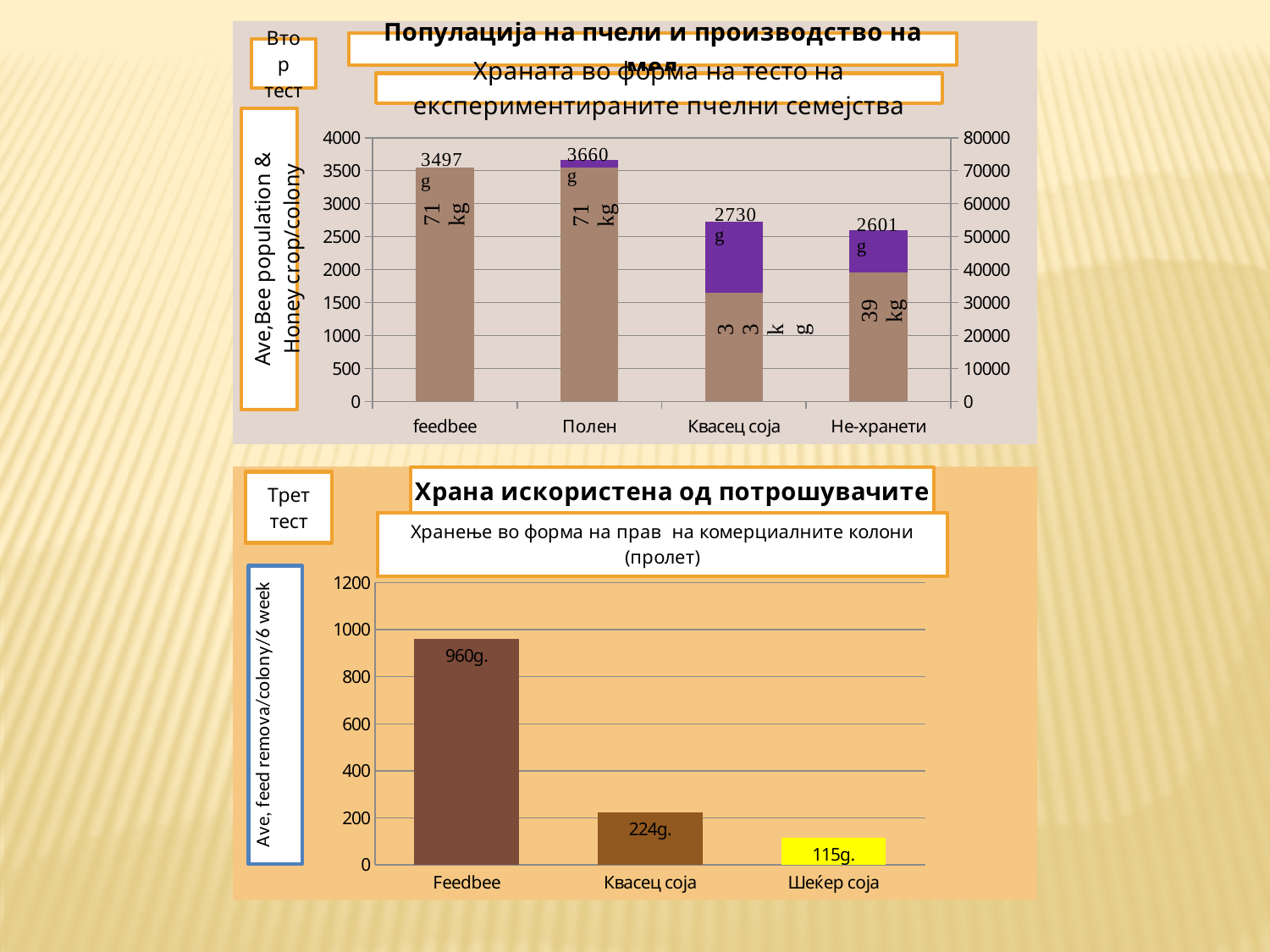
In the top chart titled 'Популација на пчели и производство на мед', which category has the lowest labelled value? Не-хранети In the chart titled 'Храна искористена од потрошувачите', which category has the lowest value? Шеќер соја In the chart titled 'Храна искористена од потрошувачите', what is the value for Feedbee? 960g. In the top chart titled 'Популација на пчели и производство на мед', what is the value labelled on the bar for Не-хранети? 2601 g In the top chart titled 'Популација на пчели и производство на мед', what is the value labelled on the bar for Полен? 3660 g In the chart titled 'Храна искористена од потрошувачите', how many categories are shown on the x axis? 3 What kind of chart is the bottom chart titled 'Храна искористена од потрошувачите'? bar chart In the chart titled 'Храна искористена од потрошувачите', what is the difference between the values for Feedbee and Квасец соја? 736g. In the top chart titled 'Популација на пчели и производство на мед', how many categories are shown on the x axis? 4 In the chart titled 'Храна искористена од потрошувачите', what is the value for Шеќер соја? 115g. In the chart titled 'Храна искористена од потрошувачите', which category has the highest value? Feedbee In the chart titled 'Храна искористена од потрошувачите', what is the value for Квасец соја? 224g.